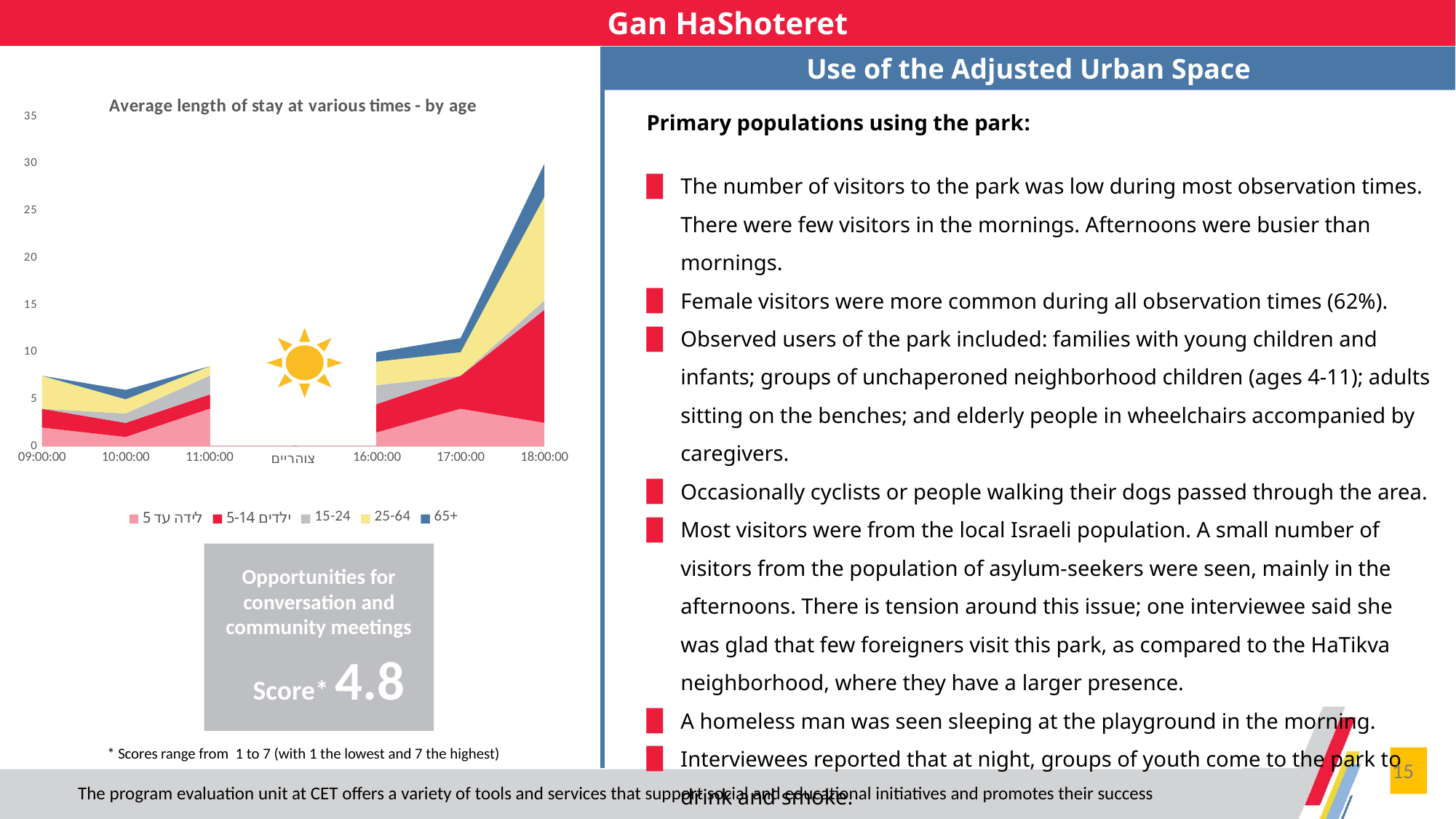
Which colour represents the 65+ age group in the chart? Blue Is the total value at 18:00:00 greater or less than 25? greater Do the total values rise or fall from 16:00:00 to 18:00:00? rise At which time is the total average length of stay highest? 18:00:00 What kind of chart is shown on the slide? Stacked area chart Is the total value at 09:00:00 greater or less than 10? less Which has a larger total value, 18:00:00 or 09:00:00? 18:00:00 Is the total value at 17:00:00 greater or less than 15? less Which has a larger total value, 16:00:00 or 10:00:00? 16:00:00 How many time points are labelled along the x axis of the chart? 7 How many series does the chart's legend list? 5 What is the title of the chart on the slide? Average length of stay at various times - by age